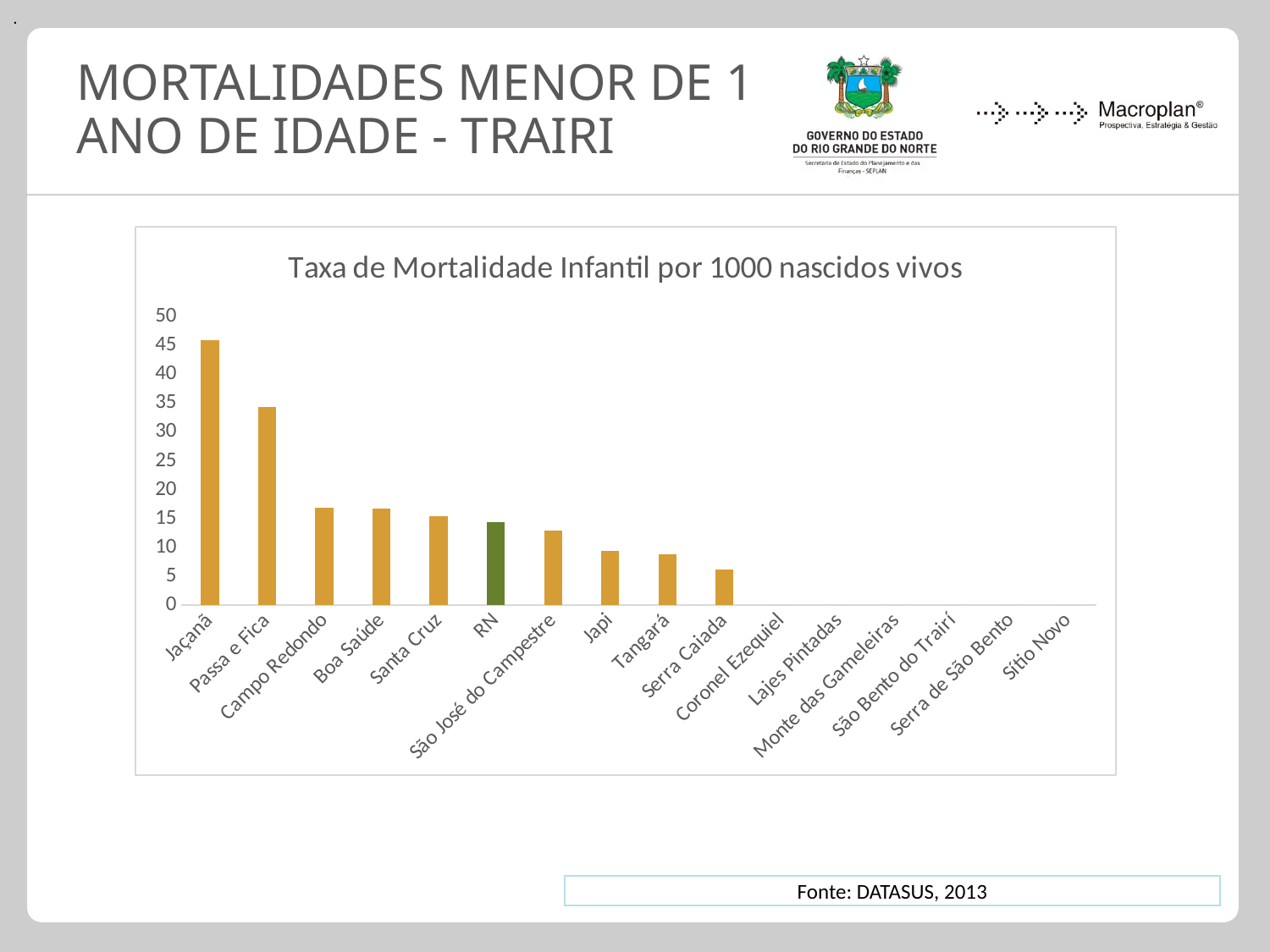
Which is larger, the value for Jaçanã or the value for Passa e Fica? Jaçanã Is the value for Jaçanã greater or less than 40? greater Is the value for Campo Redondo greater or less than 15? greater Is the value for Serra Caiada greater or less than 10? less What is the title of the chart? Taxa de Mortalidade Infantil por 1000 nascidos vivos Which category has the highest value in the chart? Jaçanã What kind of chart is shown on the slide? Bar chart How many categories are shown on the x axis of the chart? 16 Do the values generally rise or fall from left to right along the x axis? Fall Which category's bar is shown in a different colour (green) from the others? RN